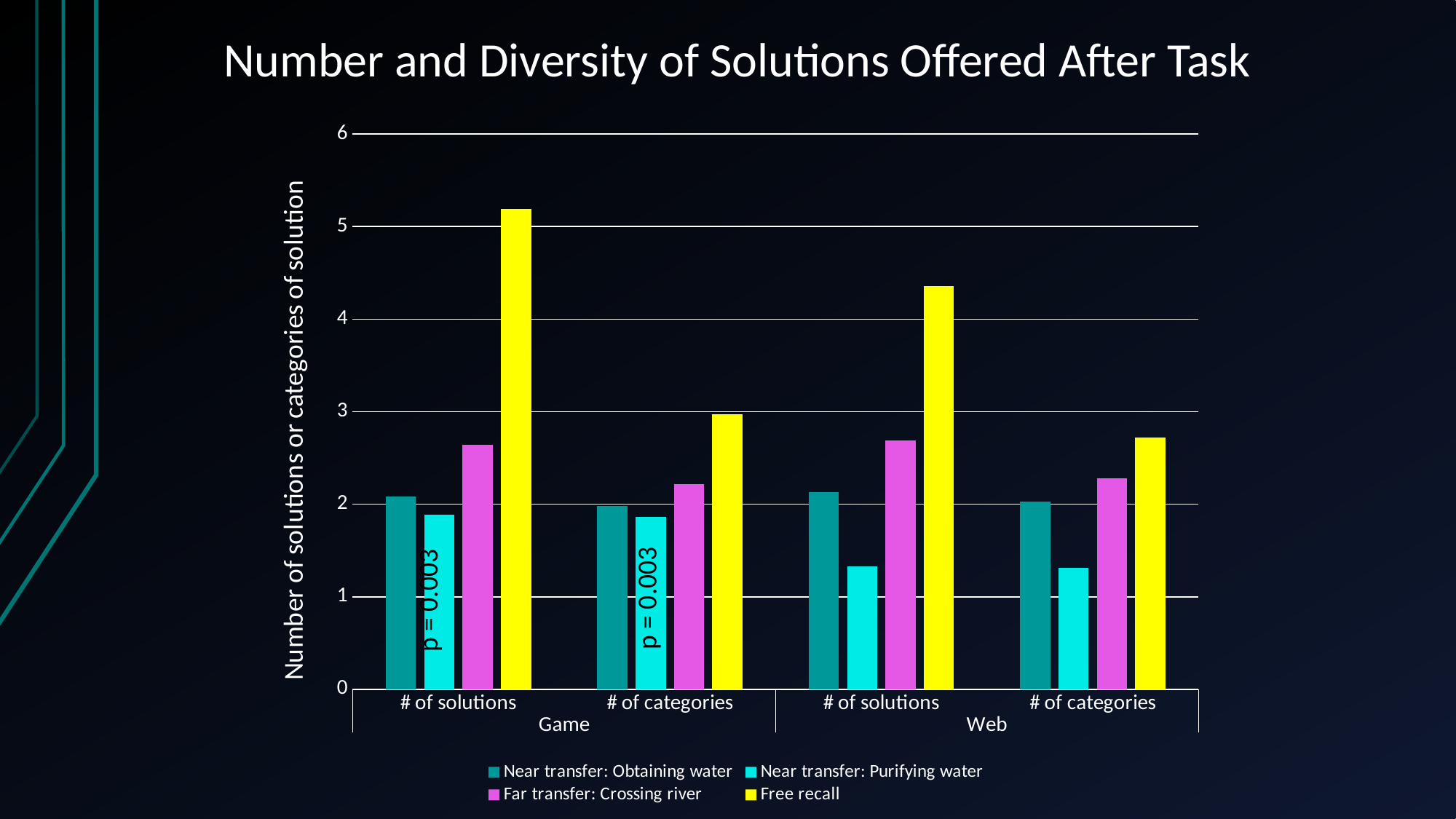
How many category groups are shown along the x axis? 4 How many series does the legend list? 4 Is the Free recall value for '# of solutions' under Web greater or less than 4? greater Which series has the highest value for '# of solutions' under Game? Free recall Is the Near transfer: Purifying water value for '# of categories' under Web greater or less than 2? less Which series has the lowest value for '# of solutions' under Web? Near transfer: Purifying water Is the Free recall value for '# of solutions' under Game greater or less than 5? greater What is the title of the chart? Number and Diversity of Solutions Offered After Task Which is larger: the Free recall value for '# of solutions' under Game or under Web? Game For '# of solutions' under Web, which is larger: Far transfer: Crossing river or Near transfer: Obtaining water? Far transfer: Crossing river What kind of chart is shown on the slide? bar chart